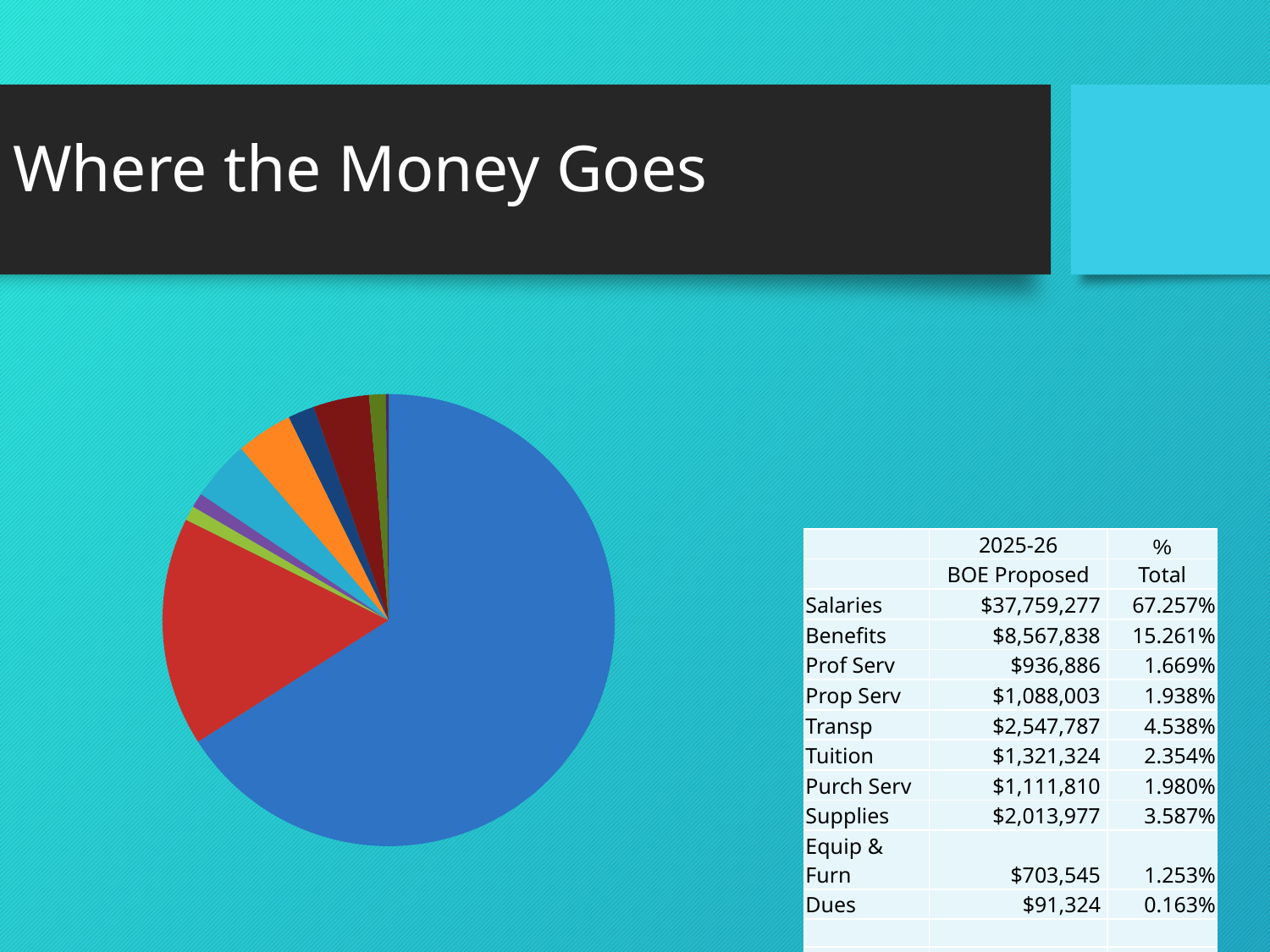
According to the table next to the pie chart, what percentage of the total is Supplies? 3.587% How many categories are listed in the table next to the pie chart? 10 What is the title of the slide containing the pie chart? Where the Money Goes According to the table next to the pie chart, what is the difference between the percentage for Salaries and the percentage for Benefits? 51.996% According to the table next to the pie chart, which category has the smallest share of the total? Dues What kind of chart is shown on the slide? pie chart According to the table next to the pie chart, what percentage of the total is Benefits? 15.261% According to the table next to the pie chart, which category has the largest share of the total? Salaries Is the largest slice of the pie chart greater or less than 50% of the pie? greater According to the table next to the pie chart, which is larger: the amount for Tuition or the amount for Purch Serv? Tuition According to the table next to the pie chart, what is the 2025-26 BOE Proposed amount for Salaries? $37,759,277 According to the table next to the pie chart, what is the 2025-26 BOE Proposed amount for Transp? $2,547,787